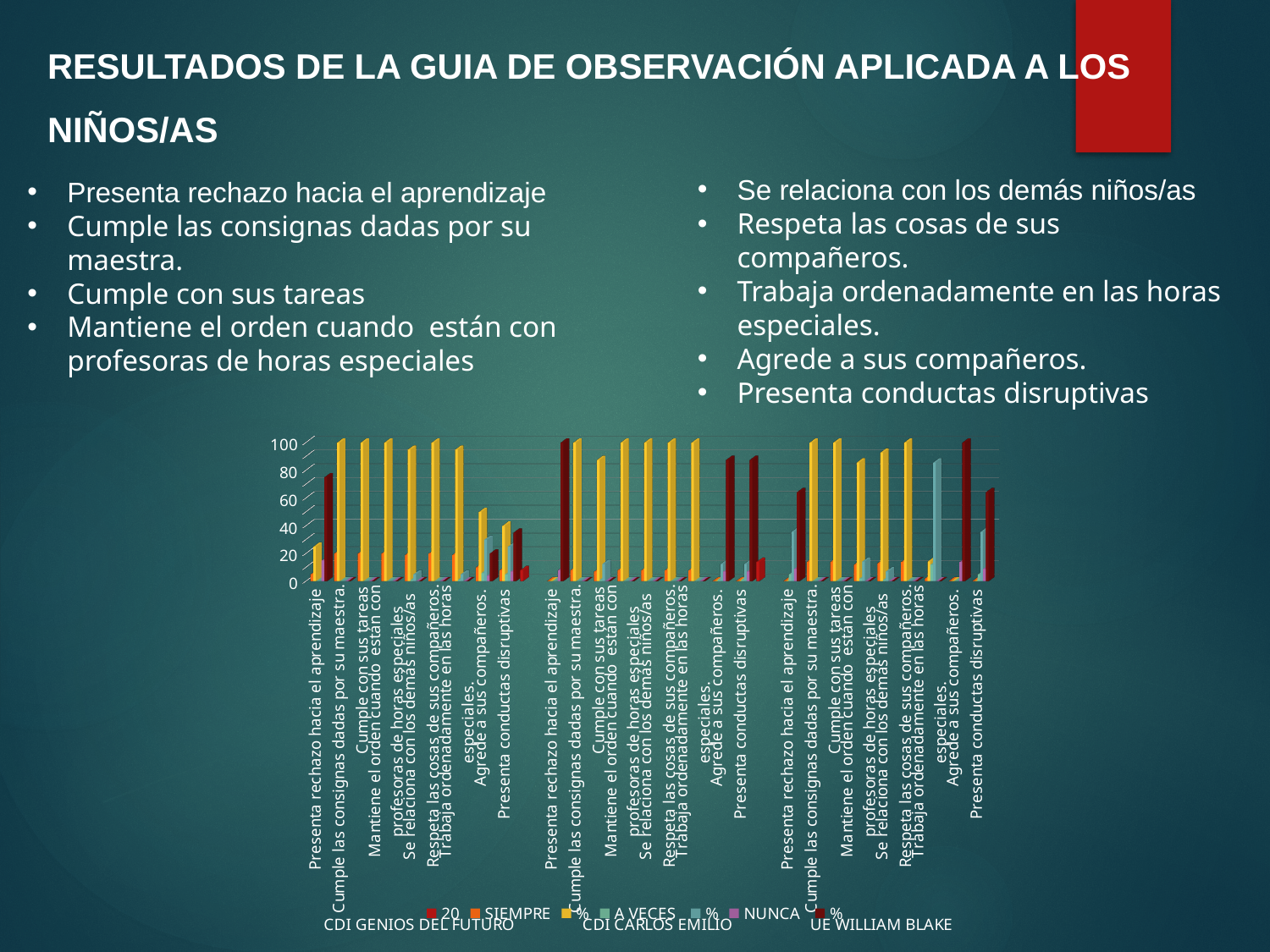
How many observation categories are plotted for each institution in the chart? 9 In the UE WILLIAM BLAKE group, is the tallest bar for "Presenta rechazo hacia el aprendizaje" greater or less than 40? greater In the CDI GENIOS DEL FUTURO group, is the tallest bar for "Cumple las consignas dadas por su maestra" greater or less than 80? greater In the CDI CARLOS EMILIO group, is the tallest bar for "Presenta rechazo hacia el aprendizaje" greater or less than 80? greater What is the name of the third institution group on the x axis of the chart? UE WILLIAM BLAKE How many institutions (groups) are shown along the x axis of the chart? 3 What is the name of the first institution group on the x axis of the chart? CDI GENIOS DEL FUTURO How many entries does the chart legend list? 7 What kind of chart is shown on the slide? bar chart